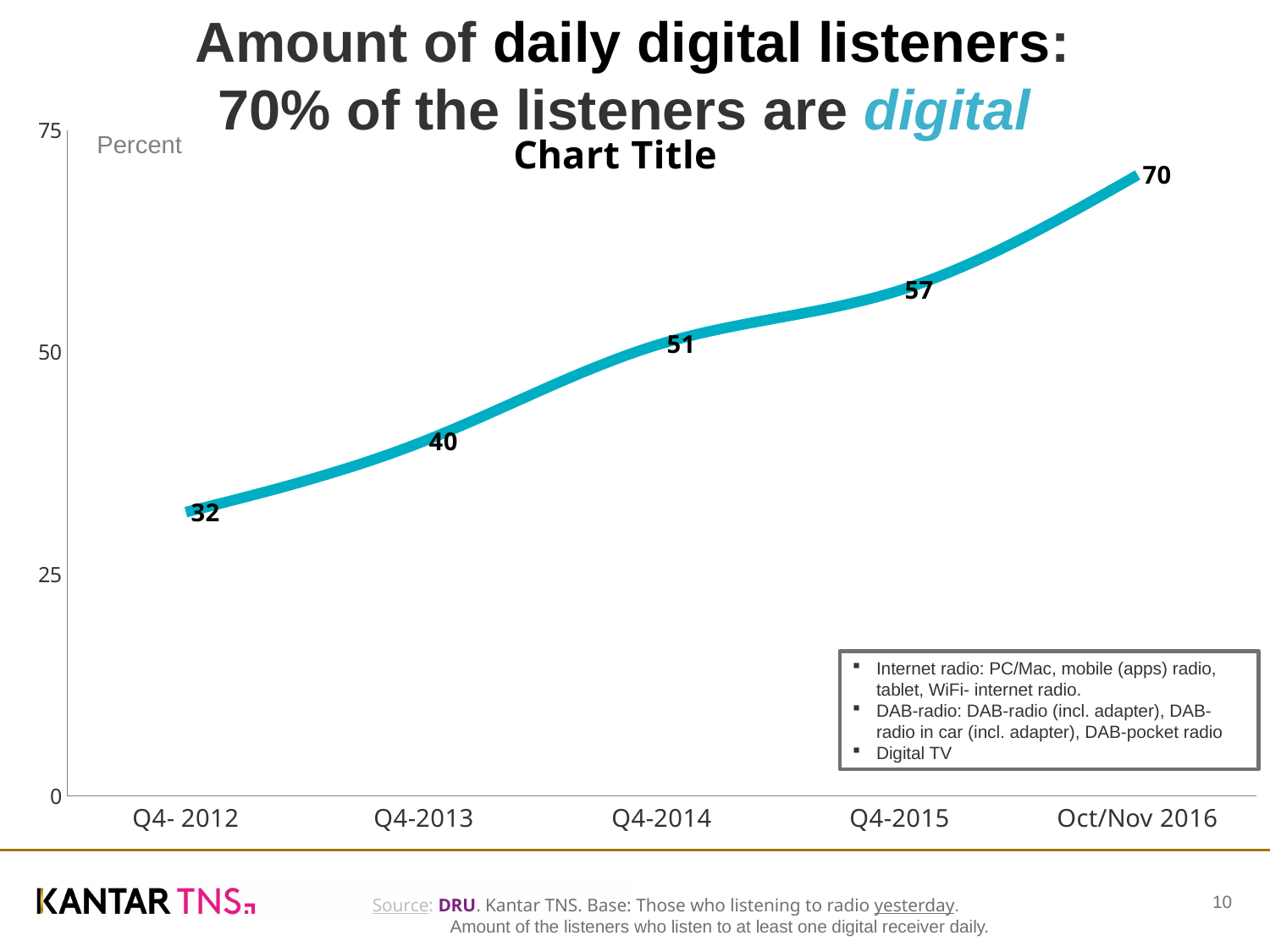
What is the value for Oct/Nov 2016? 70 Which period has the highest value? Oct/Nov 2016 Do the values rise or fall from Q4- 2012 to Oct/Nov 2016? rise What is the value for Q4-2013? 40 What is the value for Q4-2014? 51 What is the difference between the values for Q4-2015 and Q4-2014? 6 Which period has the lowest value? Q4- 2012 How many data points are plotted on the line? 5 What kind of chart is shown on the slide? line chart Which is larger, the value for Q4-2015 or the value for Q4-2013? Q4-2015 What is the difference between the values for Oct/Nov 2016 and Q4- 2012? 38 Is the value for Q4-2014 greater or less than 50? greater